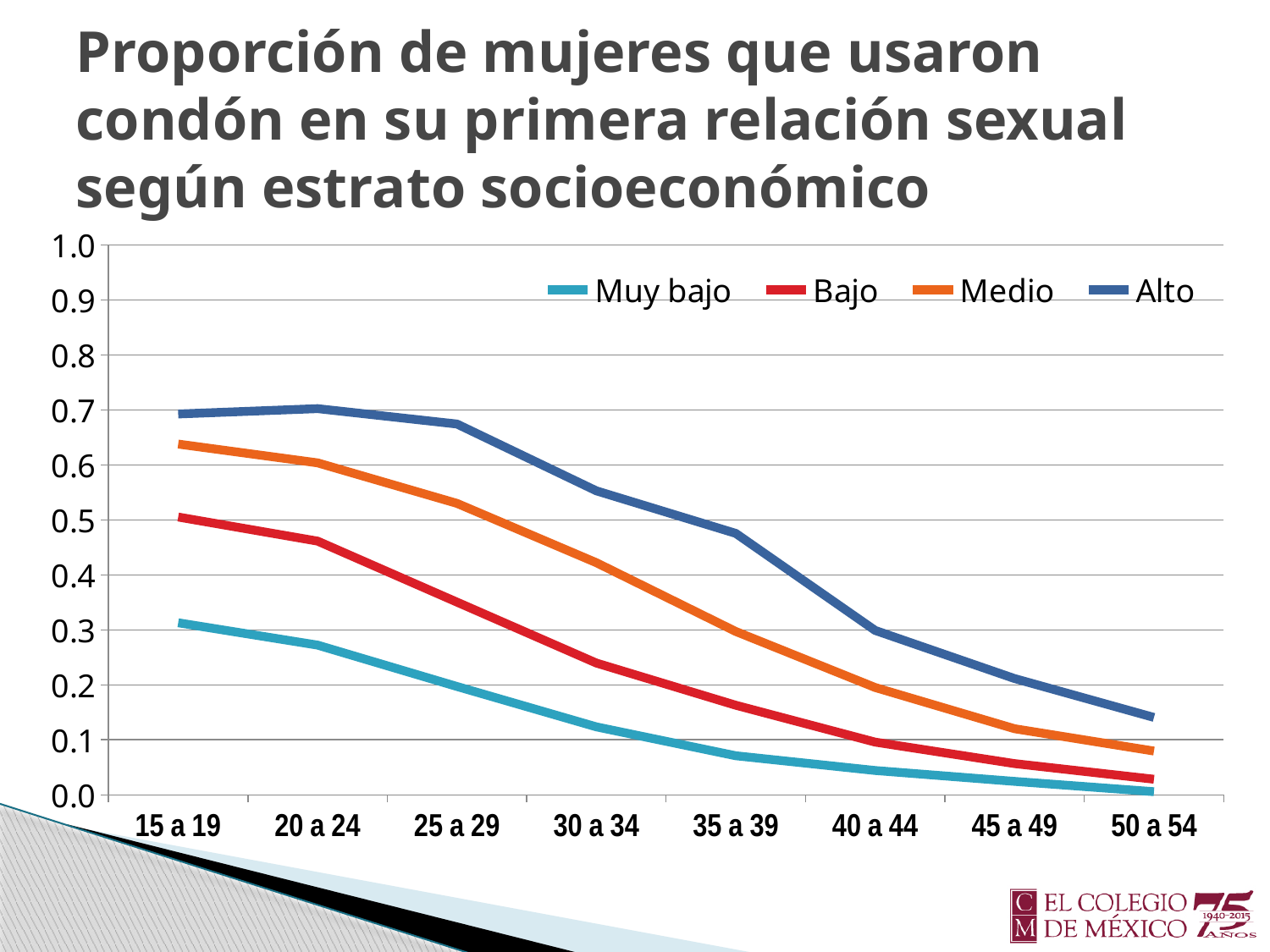
Do the values for the Alto series rise or fall from 20 a 24 to 50 a 54? fall At 30 a 34, which is larger: the value for Medio or the value for Bajo? Medio Which series has the lowest value at 50 a 54? Muy bajo Is the value for Alto at 15 a 19 greater or less than 0.6? greater How many age groups are shown along the x axis? 8 Is the value for Medio at 50 a 54 greater or less than 0.1? less Is the value for Muy bajo at 15 a 19 greater or less than 0.4? less How many series does the legend list? 4 What kind of chart is shown on the slide? line chart Which series has the highest value at 25 a 29? Alto Which series is drawn in orange in the legend? Medio